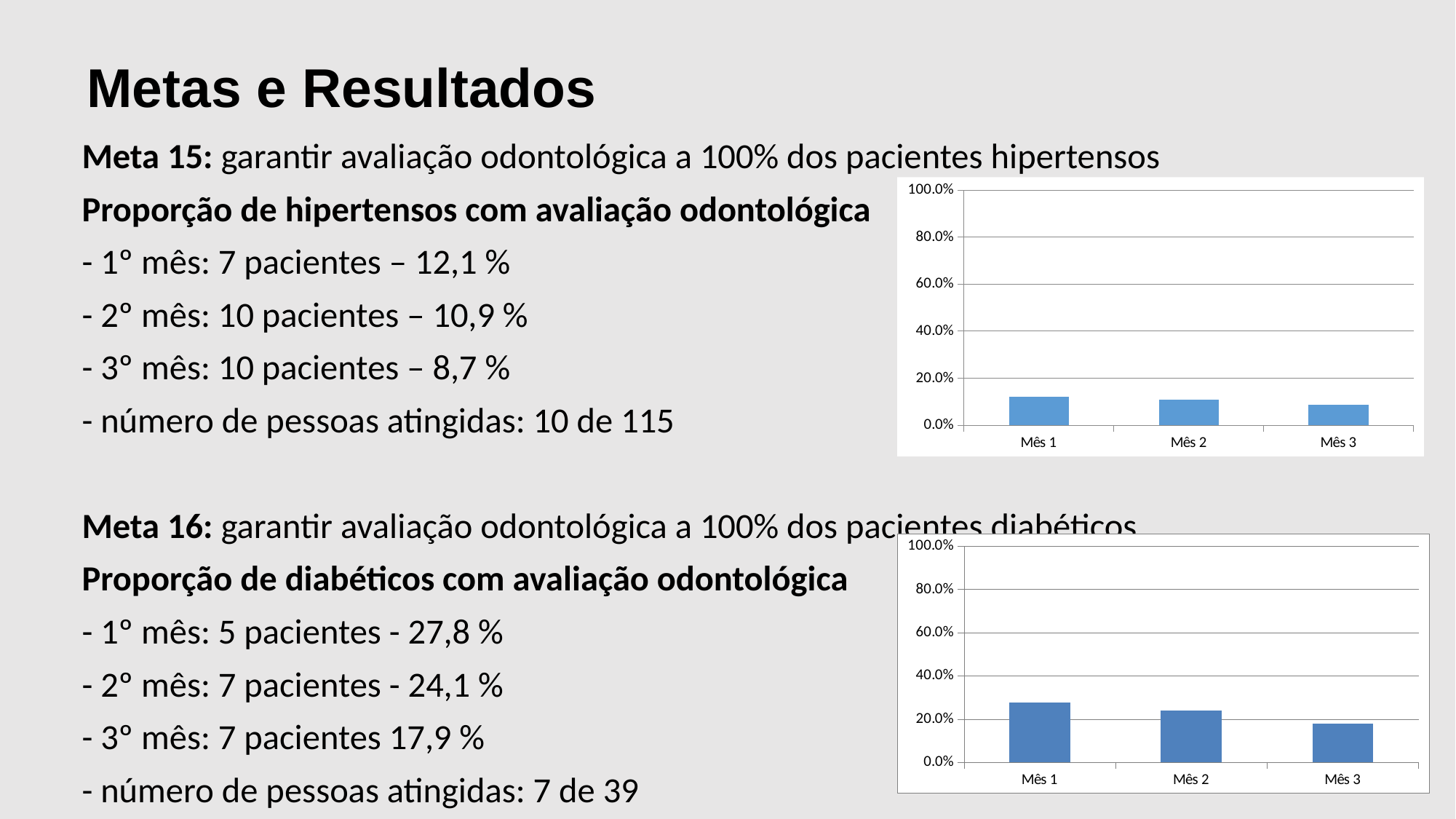
In the top chart (next to Meta 15), is the value for Mês 3 greater or less than 20.0%? less In the top chart (next to Meta 15), how many months are plotted? 3 In the bottom chart (next to Meta 16), is the value for Mês 3 greater or less than 20.0%? less In the top chart (next to Meta 15), do the values rise or fall from Mês 1 to Mês 3? fall In the bottom chart (next to Meta 16), which month has the lowest bar? Mês 3 In the top chart (next to Meta 15), which month has the highest bar? Mês 1 In the top chart (next to Meta 15), is the value for Mês 1 greater or less than 20.0%? less In the bottom chart (next to Meta 16), which is larger, the value for Mês 1 or the value for Mês 3? Mês 1 What kind of chart is the bottom chart (next to Meta 16)? bar chart In the top chart (next to Meta 15), which month has the lowest bar? Mês 3 In the bottom chart (next to Meta 16), which month has the highest bar? Mês 1